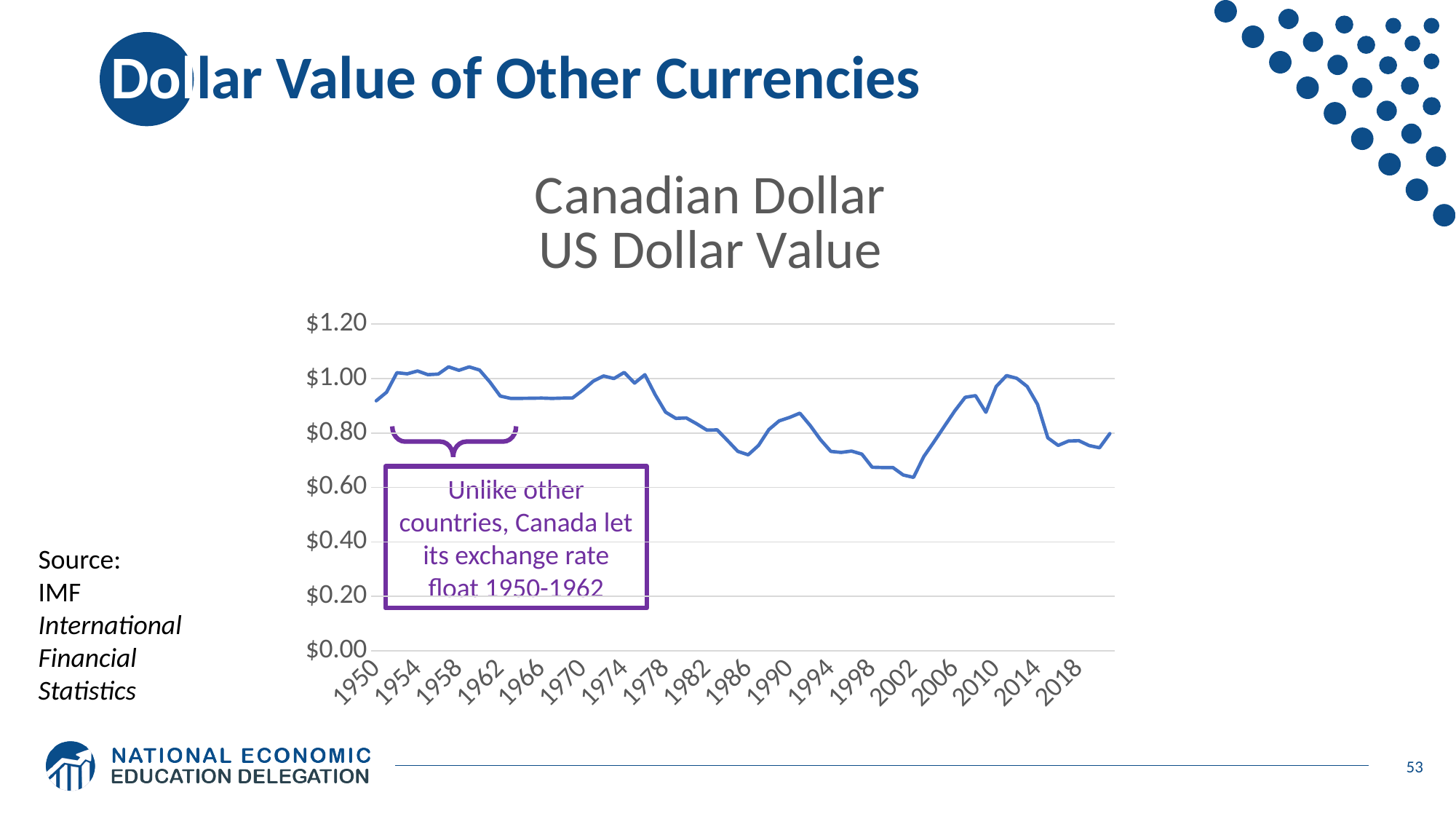
How many year labels are shown along the x axis of the chart? 18 Is the value for 1986 greater or less than $0.80? less Is the value for 2002 greater or less than $0.80? less What kind of chart is shown on the slide? line chart Is the value for 1978 greater or less than $0.80? greater What is the highest value shown on the vertical axis of the chart? $1.20 Does the value rise or fall between 2002 and 2010? rise What is the title of the chart? Canadian Dollar US Dollar Value Does the value rise or fall between 1974 and 1986? fall Which year has the larger value, 1958 or 2002? 1958